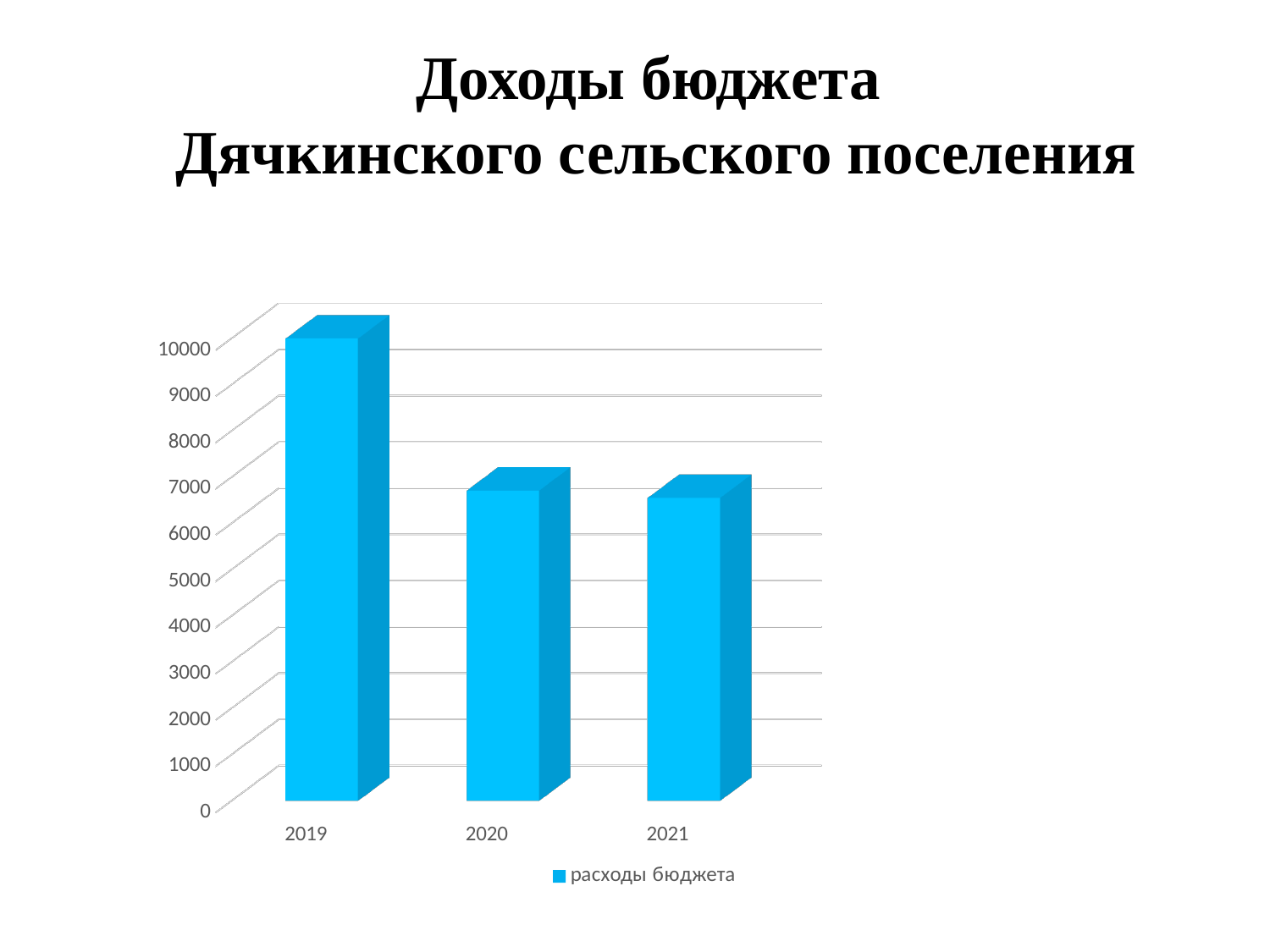
How many years (categories) are shown on the x axis of the chart? 3 What is the name of the series shown in the chart legend? расходы бюджета What is the title of the slide above the chart? Доходы бюджета Дячкинского сельского поселения Which year has the highest bar in the chart? 2019 What kind of chart is shown on the slide? bar chart Which is larger, the value for 2019 or the value for 2020? 2019 Is the value for 2020 greater or less than 5000? greater Is the value for 2019 greater or less than 9000? greater Is the value for 2020 greater or less than 8000? less Do the values rise or fall from 2019 to 2021 along the x axis? fall How many series does the chart legend list? 1